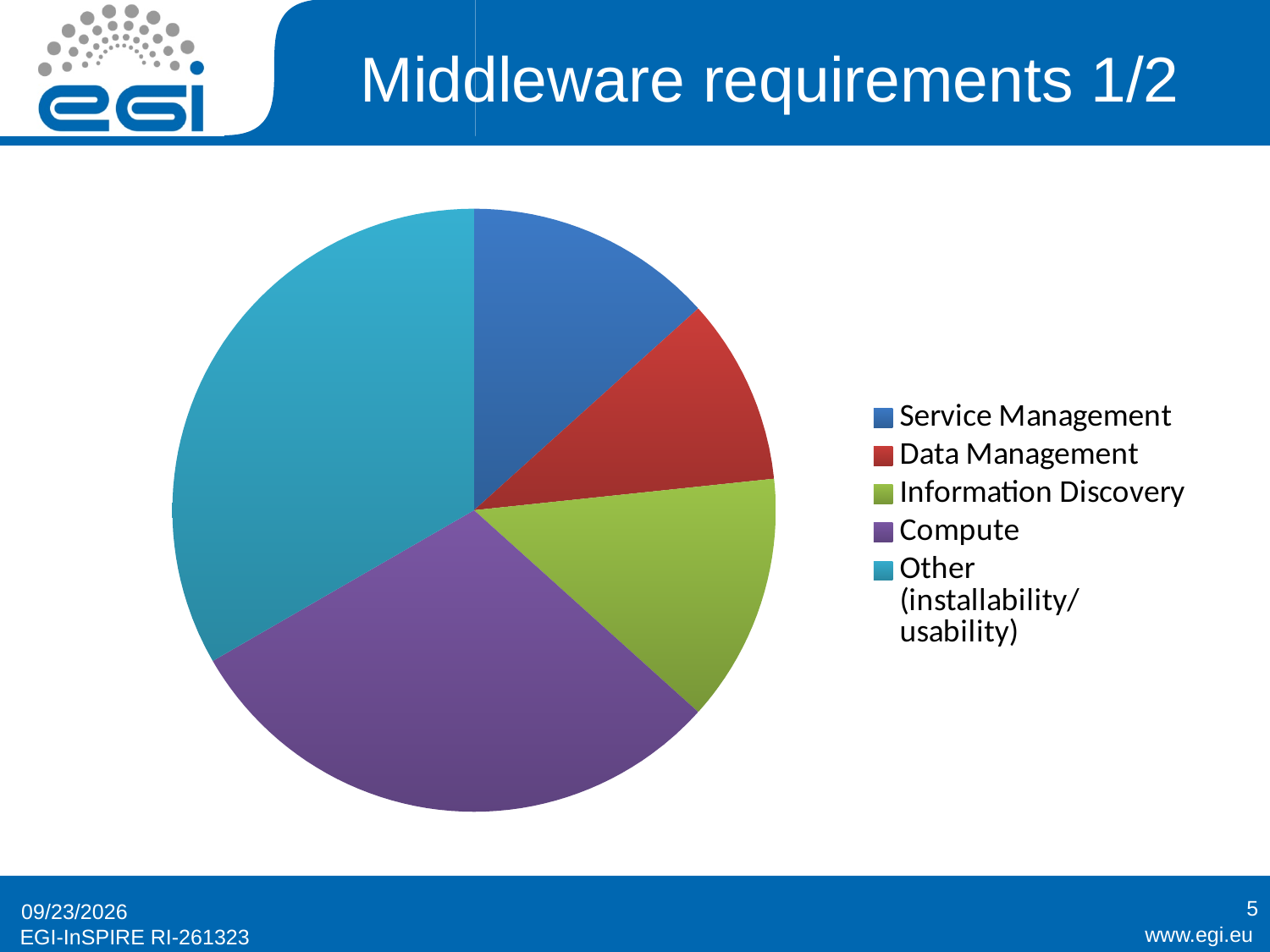
Which category has the largest slice of the pie? Other (installability/usability) What colour is the Compute slice in the pie chart? Purple What kind of chart is shown on the slide? Pie chart Which slice is larger, Compute or Information Discovery? Compute Which category has the smallest slice of the pie? Data Management What is the title of the slide containing the pie chart? Middleware requirements 1/2 Which slice is larger, Other (installability/usability) or Service Management? Other (installability/usability) How many slices does the pie chart have? 5 Which slice is larger, Compute or Data Management? Compute How many entries does the legend list? 5